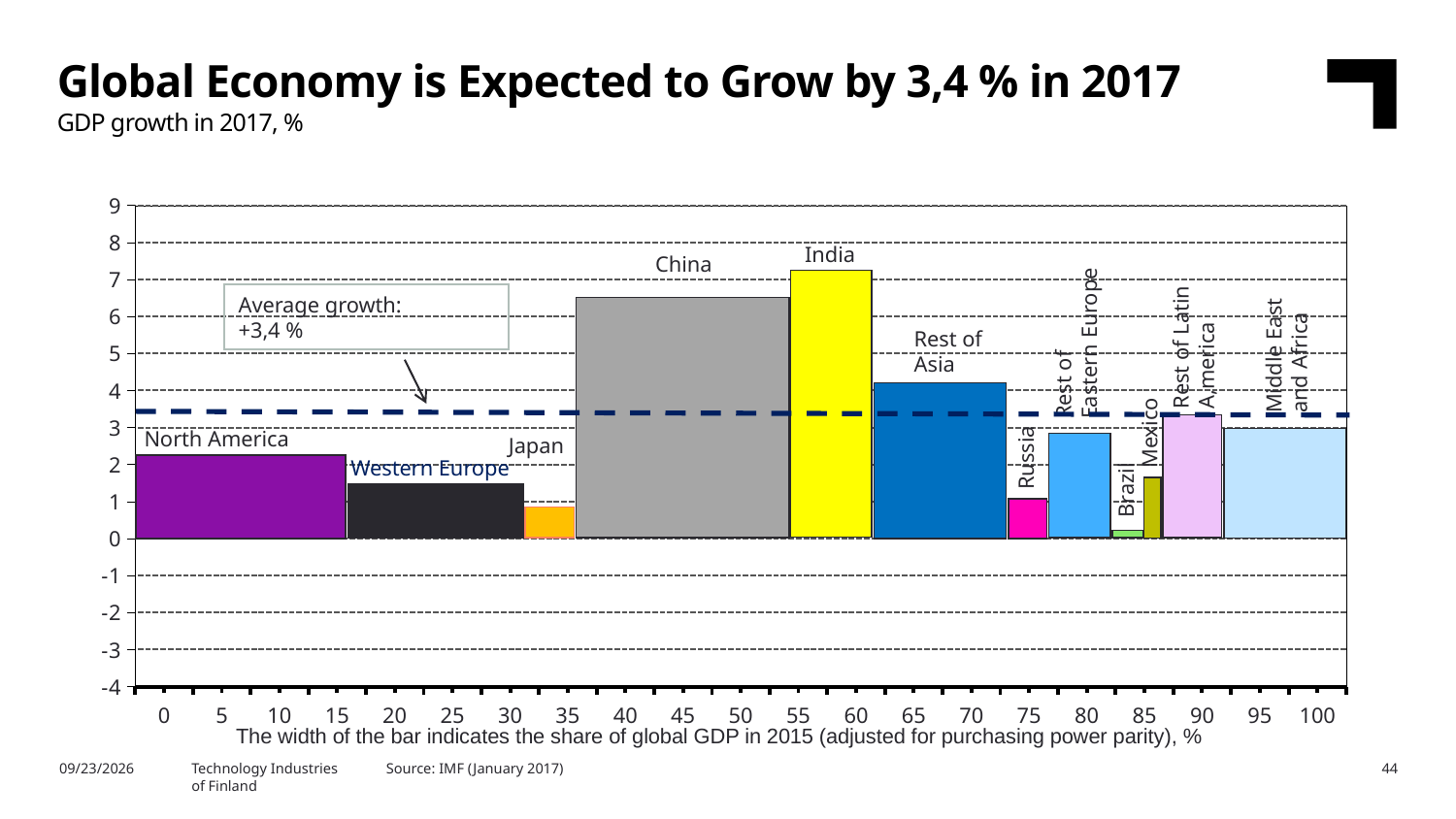
How many regions are shown as bars in the chart? 12 Which region has the highest GDP growth in 2017 in the chart? India What kind of chart is shown on the slide? bar chart According to the note below the chart, what does the width of each bar indicate? The share of global GDP in 2015 (adjusted for purchasing power parity), % Is the GDP growth value for Rest of Asia greater or less than 4? greater Which has the higher GDP growth in 2017, China or Rest of Asia? China Is the GDP growth value for Japan greater or less than 1? less Which region has the lowest GDP growth in 2017 in the chart? Brazil What average growth value is printed in the chart's annotation box? +3,4 % Is the GDP growth value for China greater or less than 6? greater Which has the higher GDP growth in 2017, North America or Western Europe? North America